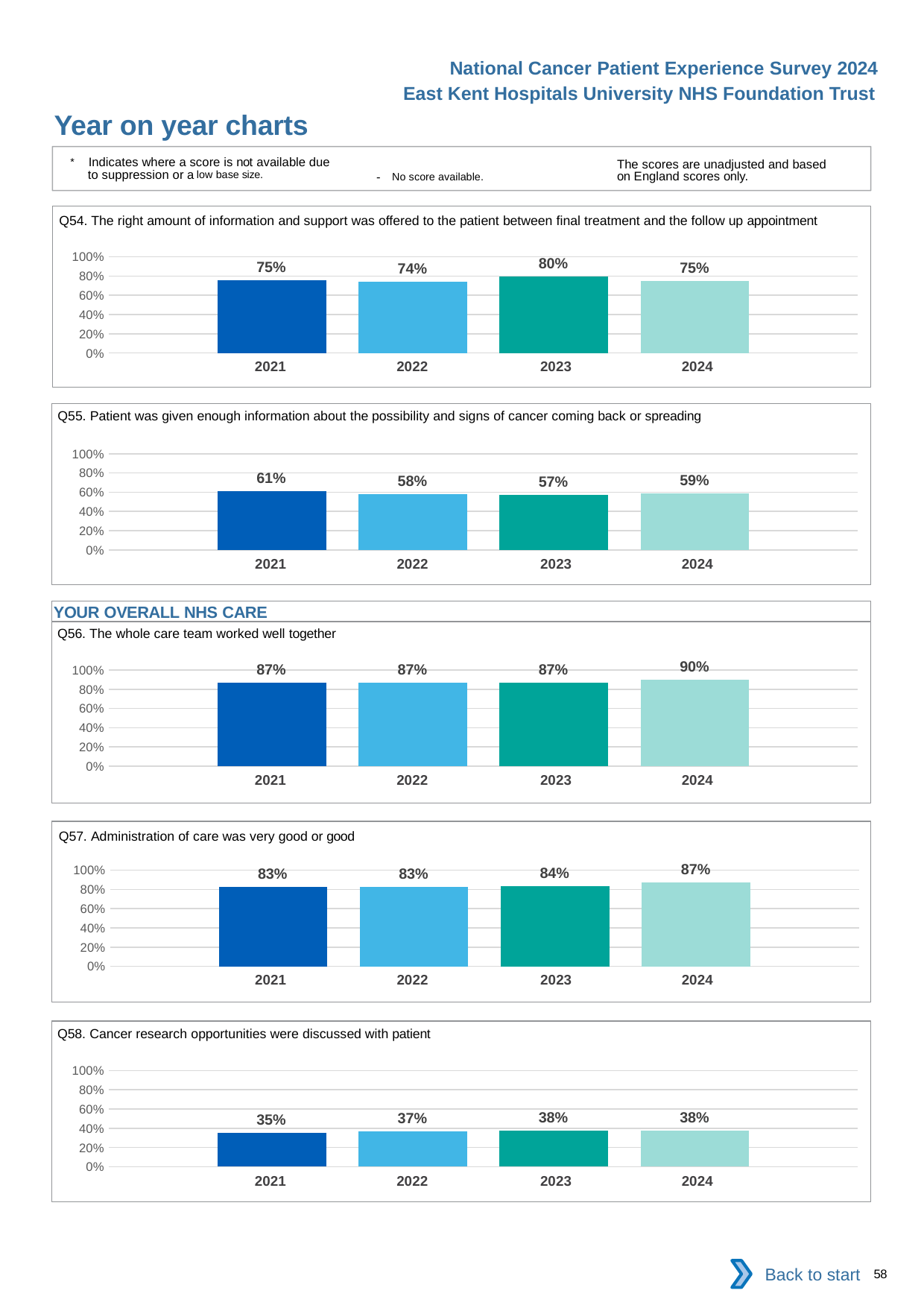
In the Q54 chart, which year has the highest value? 2023 In the Q58 chart, what is the value for 2021? 35% In the Q57 chart, which is larger, the value for 2023 or the value for 2024? 2024 In the Q55 chart, what is the difference between the 2021 and 2023 values? 4% What kind of chart is the Q58 chart? bar chart In the Q56 chart, how many years are shown? 4 In the Q56 chart, what is the value for 2024? 90% In the Q58 chart, is the value for 2024 greater or less than 40%? less In the Q55 chart, which year has the lowest value? 2023 In the Q54 chart, what is the value for 2023? 80% In the Q57 chart, what is the difference between the 2024 and 2021 values? 4% In the Q55 chart, what is the value for 2021? 61%